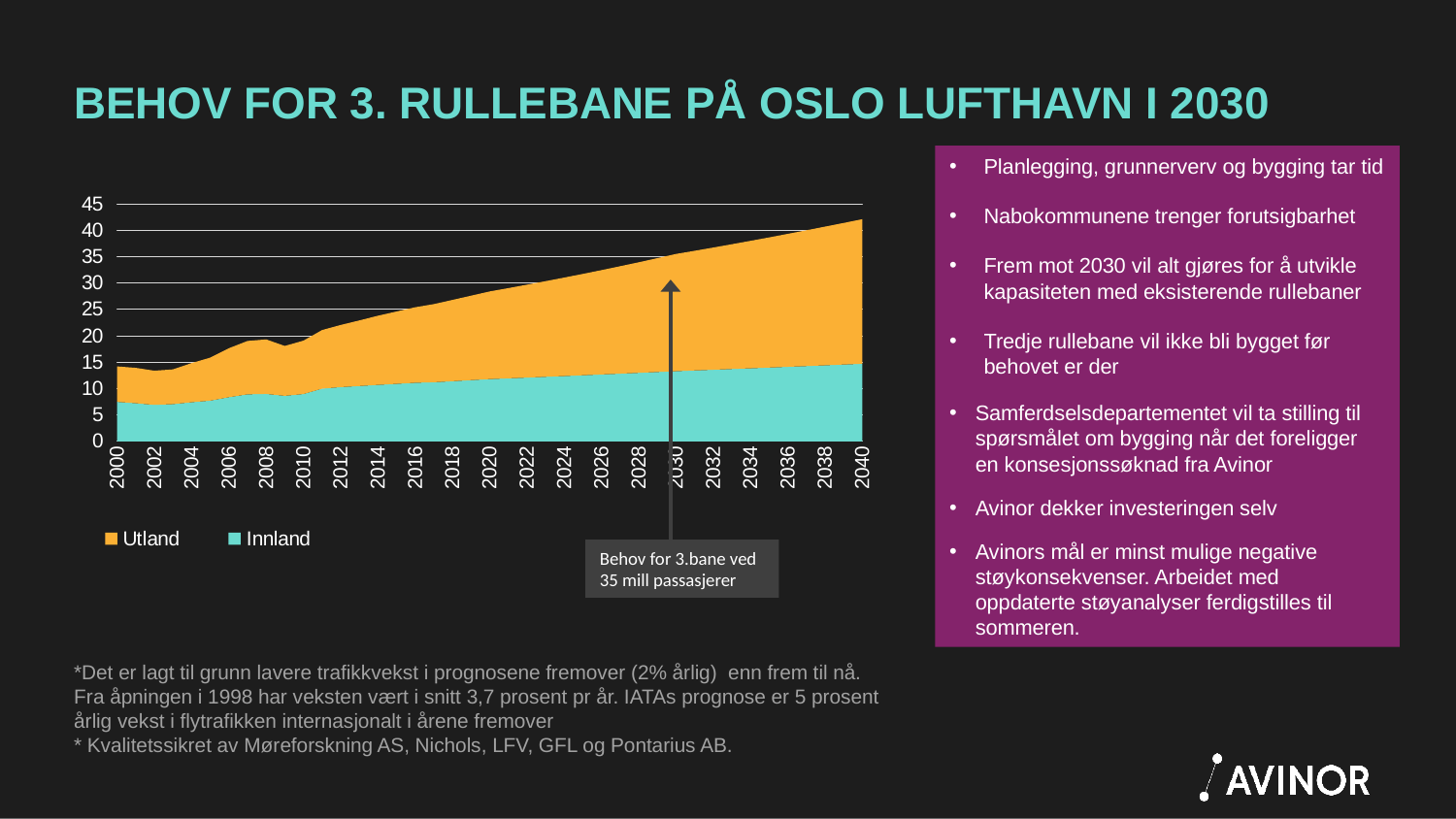
Do the total values rise or fall from 2000 to 2040? Rise What kind of chart is shown on the slide? Stacked area chart Is the value for Innland in 2000 greater or less than 10? less How many year labels are shown on the x axis? 21 How many series does the legend list? 2 Is the value for Innland in 2040 greater or less than 10? greater In 2040, which series has the larger value, Utland or Innland? Utland Is the total (top of the stacked area) in 2040 greater or less than 40? greater What is the highest value shown on the y axis? 45 What are the two series named in the legend? Utland and Innland Which series is shown in orange? Utland